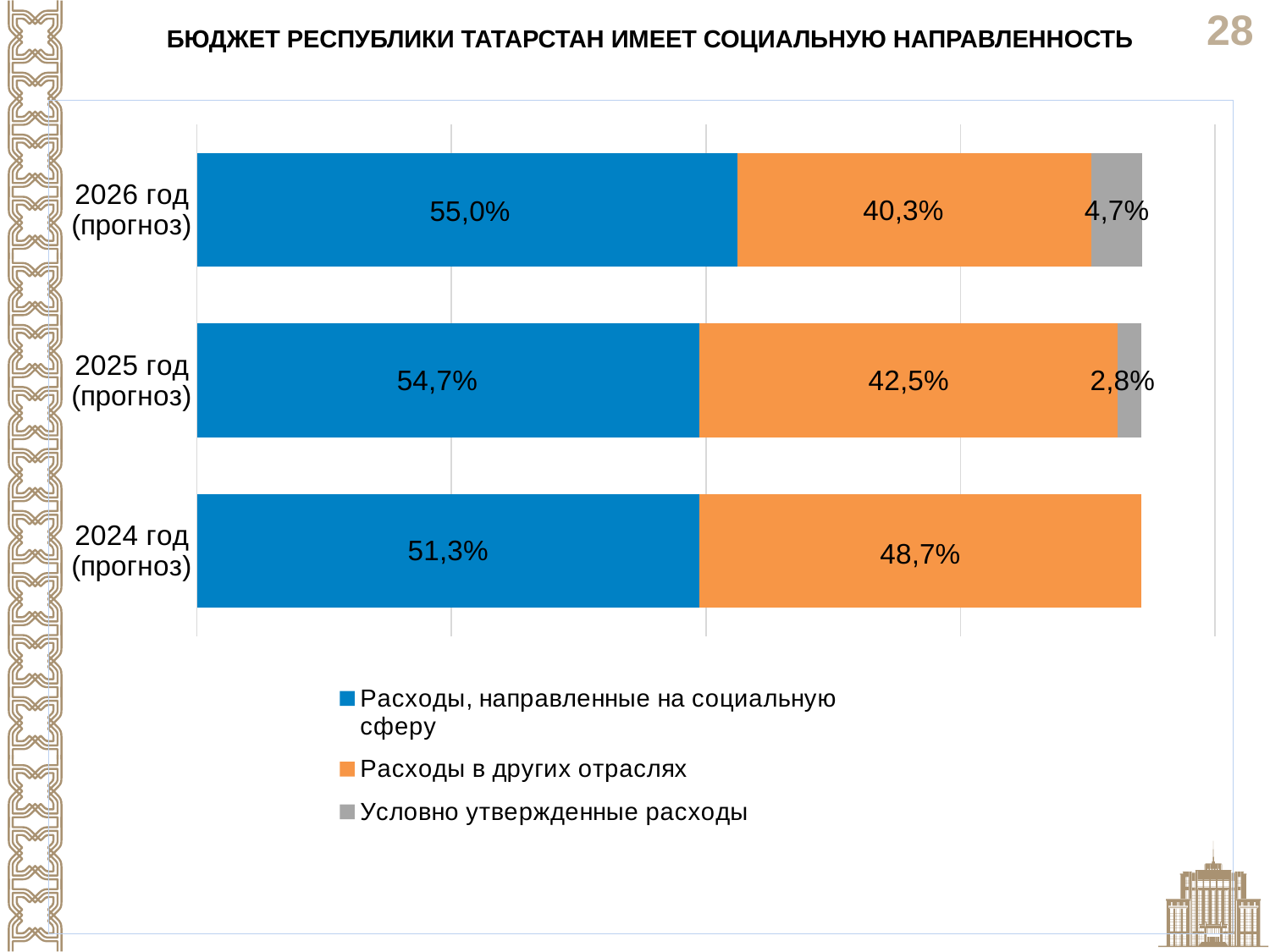
What is the value for "Расходы, направленные на социальную сферу" in 2026 год (прогноз)? 55,0% In which year is the share of "Расходы, направленные на социальную сферу" the highest? 2026 год (прогноз) What is the total of the stacked bar for 2025 год (прогноз)? 100,0% What is the value for "Условно утвержденные расходы" in 2025 год (прогноз)? 2,8% What kind of chart is shown on the slide? Stacked bar chart Which colour represents "Расходы в других отраслях" in the chart? Orange In which year is the share of "Расходы в других отраслях" the lowest? 2026 год (прогноз) What is the value for "Расходы в других отраслях" in 2024 год (прогноз)? 48,7% What is the difference between the "Расходы, направленные на социальную сферу" values for 2026 год (прогноз) and 2024 год (прогноз)? 3,7 percentage points How many years (categories) are shown on the chart? 3 How many series does the legend list? 3 Which is larger: "Условно утвержденные расходы" in 2026 год (прогноз) or in 2025 год (прогноз)? 2026 год (прогноз)